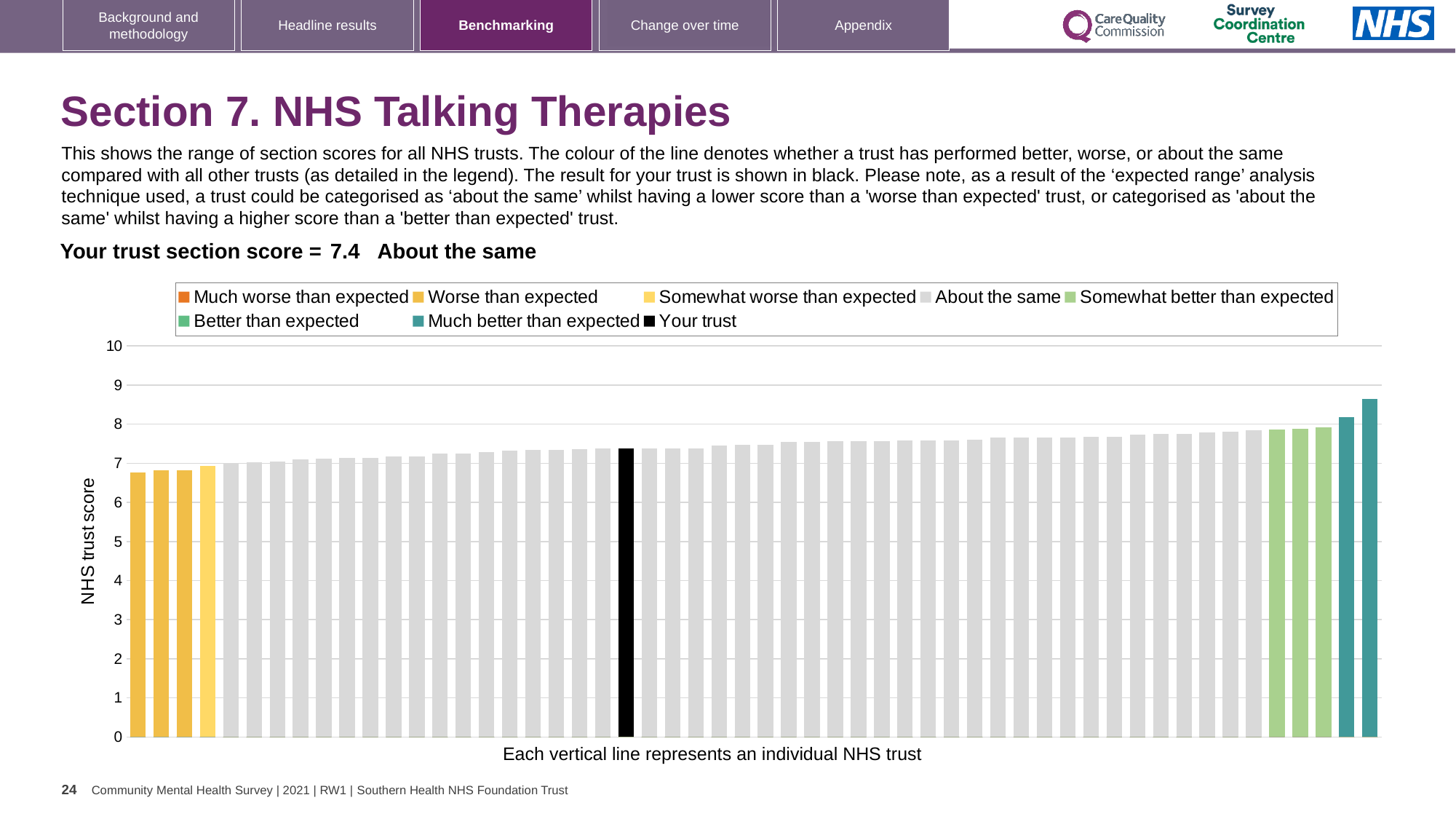
How many bars are coloured as 'Much better than expected'? 2 Is the value of the shortest bar greater or less than 7? less Do the bar values rise or fall from left to right along the x axis? rise Which benchmarking category is your trust placed in for this section? About the same Is the value of the tallest bar greater or less than 8? greater What is the section score for your trust shown on the slide? 7.4 Is the value for your trust greater or less than 7? greater How many entries does the chart legend list? 8 Which legend category does the shortest bar belong to? Worse than expected Which legend category does the tallest bar belong to? Much better than expected What kind of chart is shown on the slide? bar chart What is the title of the vertical axis? NHS trust score